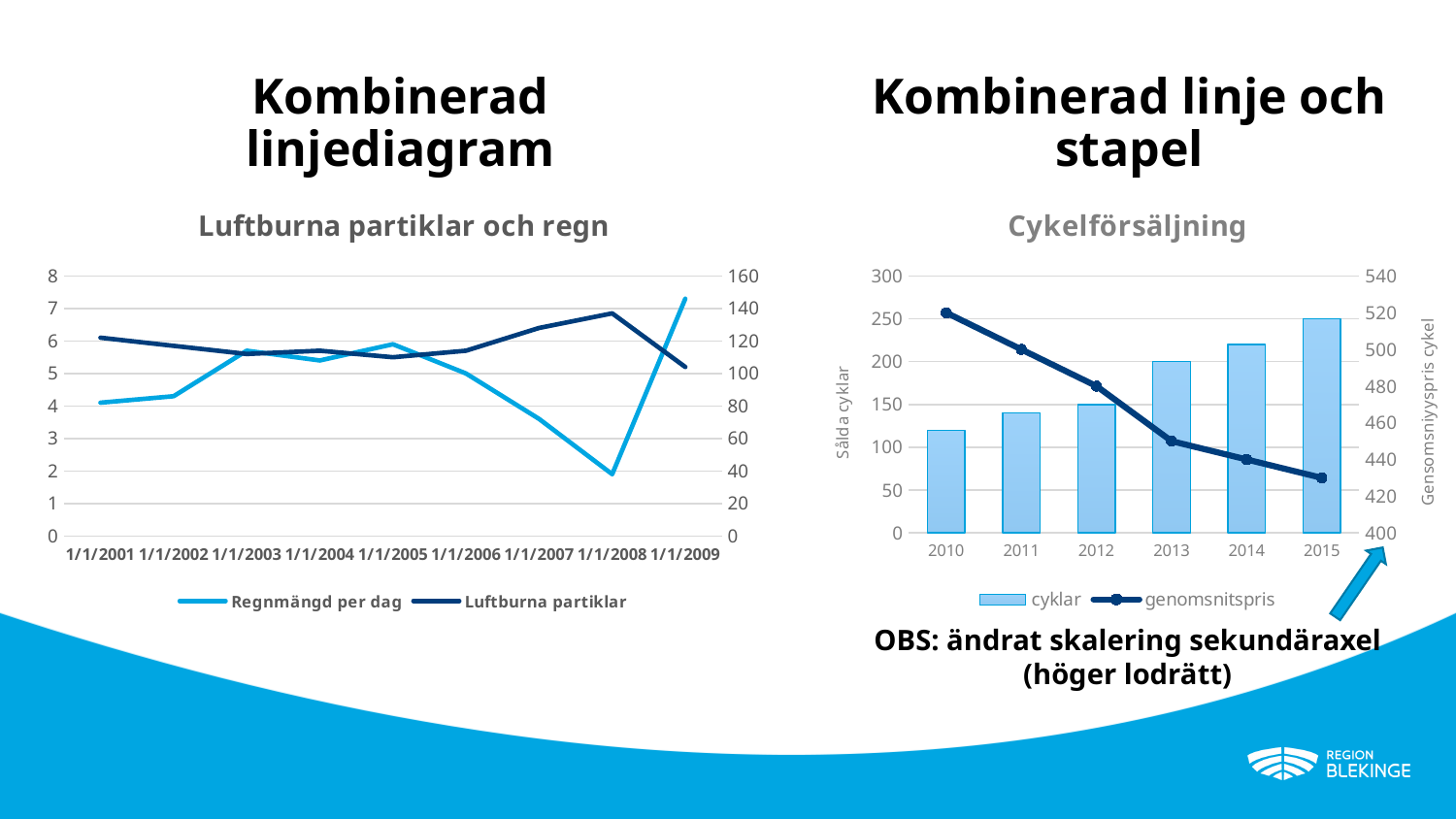
In the right chart 'Cykelförsäljning', what is the value of the 'cyklar' bar for 2013? 200 How many dates are shown on the x axis of the left chart 'Luftburna partiklar och regn'? 9 In the right chart 'Cykelförsäljning', do the 'cyklar' bars rise or fall from 2010 to 2015? rise What kind of chart is the left chart titled 'Luftburna partiklar och regn'? line chart In the right chart 'Cykelförsäljning', what is the value of the 'cyklar' bar for 2015? 250 How many series does the legend of the left chart 'Luftburna partiklar och regn' list? 2 In the right chart 'Cykelförsäljning', is the 'cyklar' value for 2010 greater or less than 150? less In the left chart 'Luftburna partiklar och regn', at which date does the 'Luftburna partiklar' line reach its highest point? 1/1/2008 In the left chart 'Luftburna partiklar och regn', at which date does the 'Regnmängd per dag' line reach its lowest point? 1/1/2008 In the left chart 'Luftburna partiklar och regn', at which date does the 'Regnmängd per dag' line reach its highest point? 1/1/2009 In the right chart 'Cykelförsäljning', which year has the lowest 'cyklar' bar? 2010 In the right chart 'Cykelförsäljning', is the 'genomsnitspris' value for 2010 greater or less than 500? greater